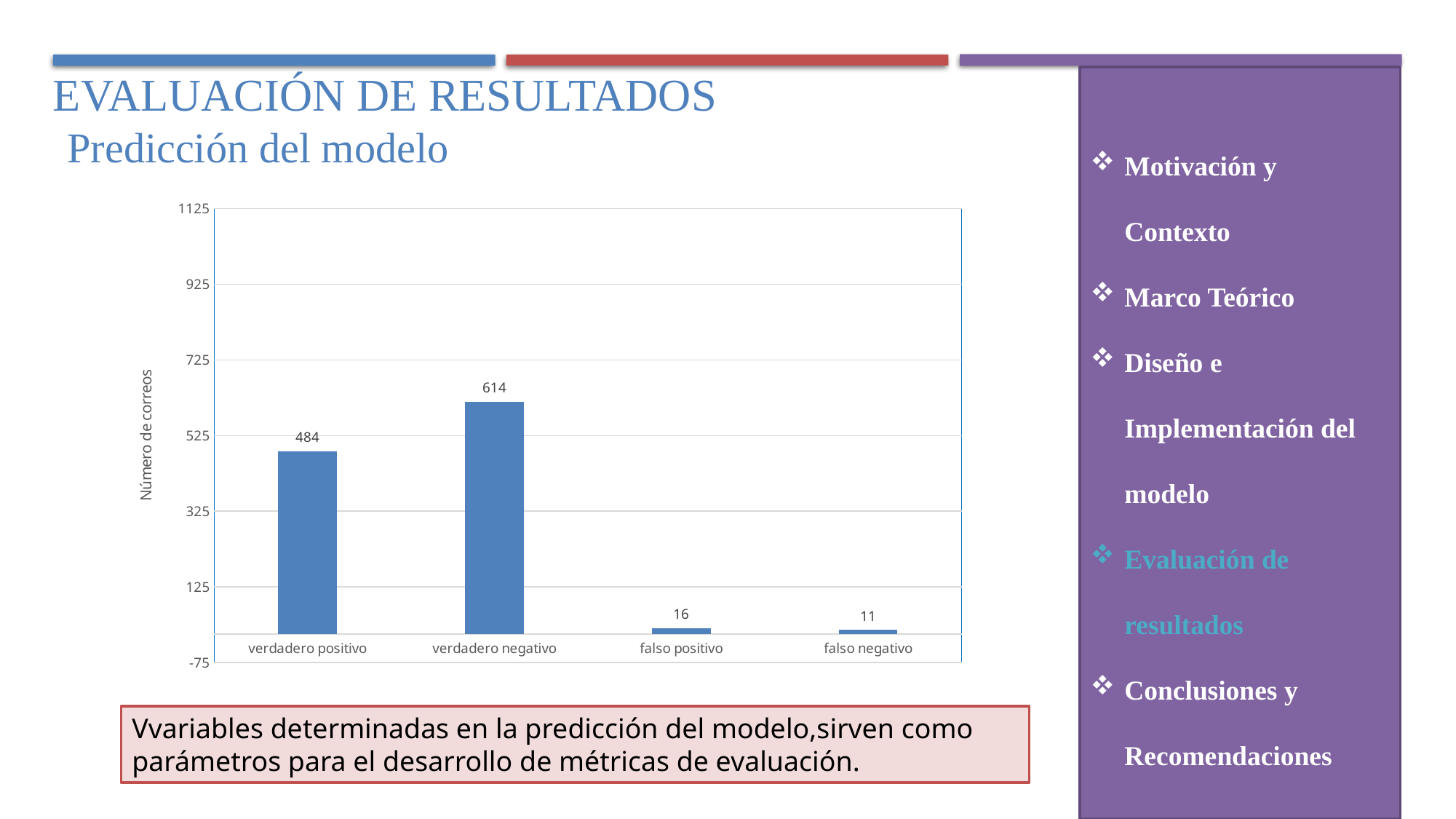
Which category has the highest value? verdadero negativo What is the difference between the values for verdadero negativo and verdadero positivo? 130 How many categories are shown on the x axis? 4 What is the label of the y axis? Número de correos Which category has the lowest value? falso negativo Is the value for verdadero positivo greater or less than 525? less What is the value for falso positivo? 16 What is the value for falso negativo? 11 What is the value for verdadero positivo? 484 Which is larger, the value for falso positivo or the value for falso negativo? falso positivo What is the value for verdadero negativo? 614 What kind of chart is shown on the slide? bar chart